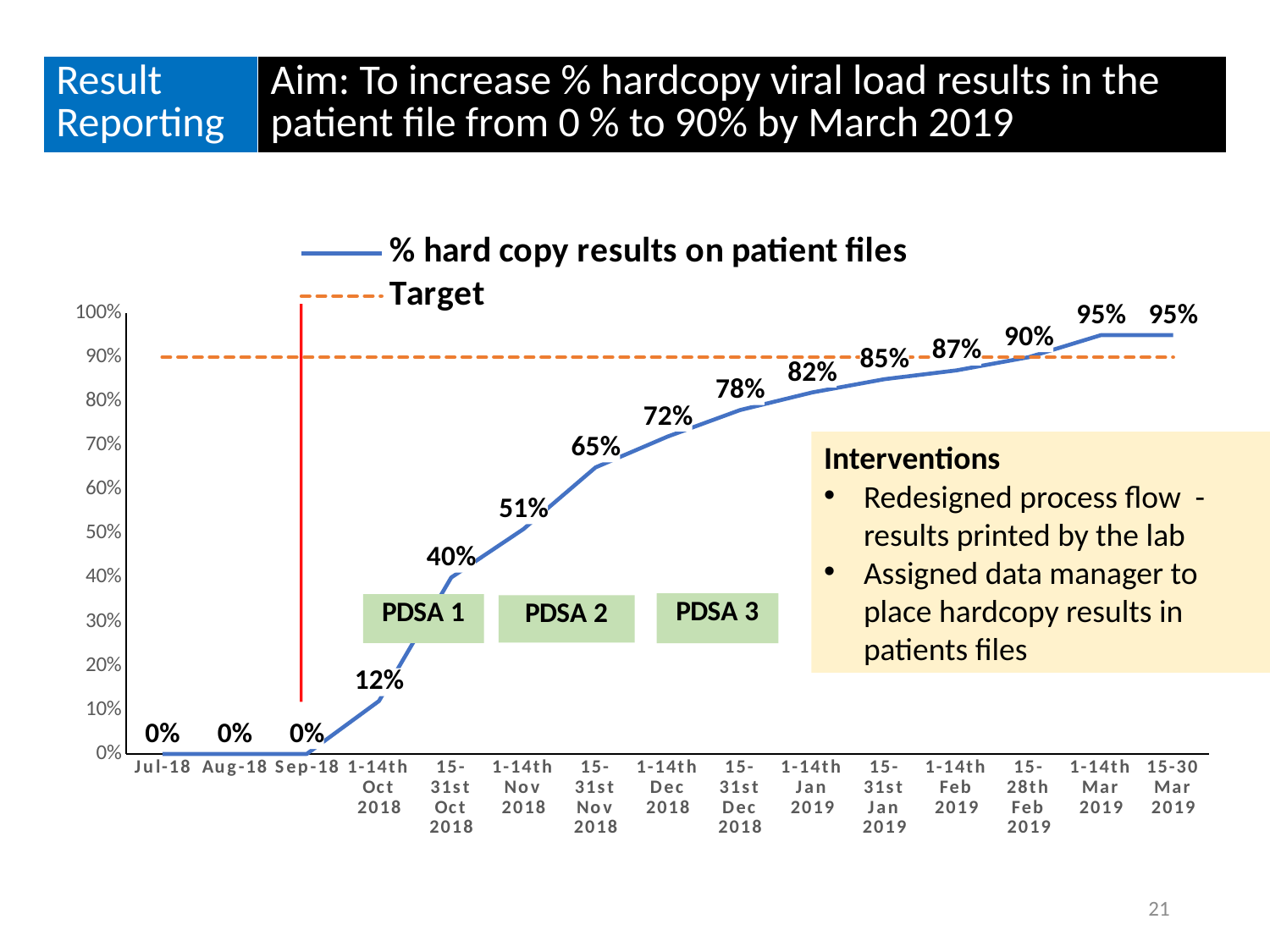
What is the difference between the values for 15-31st Oct 2018 and 1-14th Oct 2018? 28% Which is larger, the value for 15-31st Dec 2018 or the value for 1-14th Jan 2019? 1-14th Jan 2019 Is the value for 15-31st Jan 2019 greater or less than 90%? less Does the % hard copy results on patient files line rise or fall from Sep-18 to 1-14th Mar 2019? rise How many time periods are plotted along the x axis? 15 How many series does the legend list? 2 What is the value for 1-14th Feb 2019 on the % hard copy results on patient files line? 87% What is the value for 1-14th Oct 2018 on the % hard copy results on patient files line? 12% What is the value for 15-31st Nov 2018 on the % hard copy results on patient files line? 65% What is the value for 15-30 Mar 2019 on the % hard copy results on patient files line? 95% What is the difference between the values for 1-14th Dec 2018 and 1-14th Nov 2018? 21% What type of chart is shown on the slide? line chart